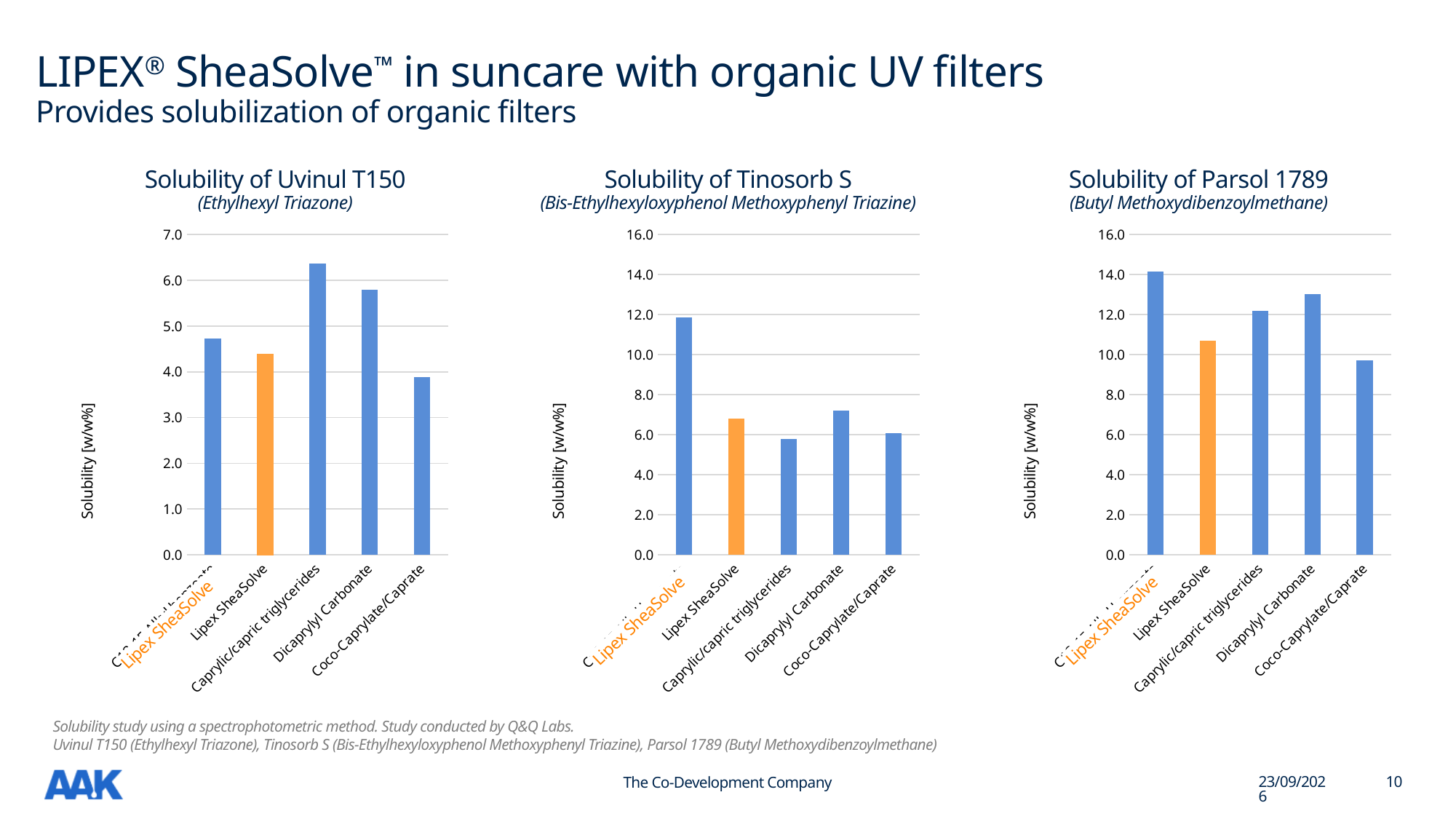
In the "Solubility of Parsol 1789" chart, which category has the lowest solubility? Coco-Caprylate/Caprate In the "Solubility of Uvinul T150" chart, which category has the highest solubility? Caprylic/capric triglycerides In the "Solubility of Tinosorb S" chart, which is larger: Dicaprylyl Carbonate or Caprylic/capric triglycerides? Dicaprylyl Carbonate In the "Solubility of Tinosorb S" chart, is the value for Lipex SheaSolve greater or less than 8.0? less In the "Solubility of Uvinul T150" chart, is the value for Lipex SheaSolve greater or less than 5.0? less In the "Solubility of Uvinul T150" chart, which category has the lowest solubility? Coco-Caprylate/Caprate How many bars are plotted in the "Solubility of Tinosorb S" chart? 5 In the "Solubility of Parsol 1789" chart, what is the label of the vertical axis? Solubility [w/w%] In the "Solubility of Uvinul T150" chart, is the value for Caprylic/capric triglycerides greater or less than 6.0? greater In the "Solubility of Parsol 1789" chart, which is larger: Caprylic/capric triglycerides or Lipex SheaSolve? Caprylic/capric triglycerides What kind of chart is the "Solubility of Uvinul T150" chart? bar chart